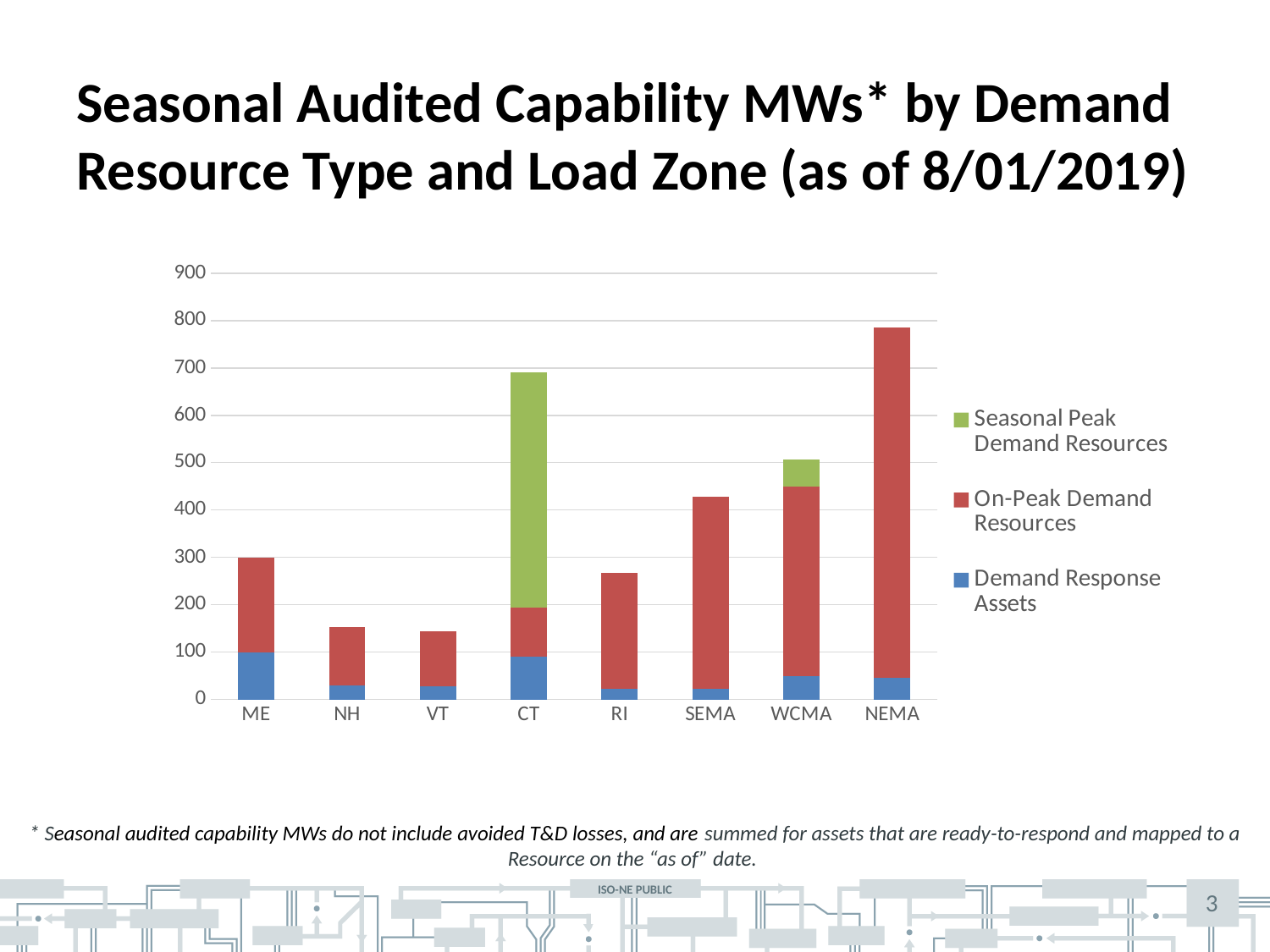
Which has a larger total, SEMA or WCMA? WCMA Which has a larger total, CT or NEMA? NEMA How many load zones are shown on the x axis of the chart? 8 Is the total value for ME greater or less than 400? less Is the total value for CT greater or less than 600? greater What kind of chart is shown on the slide? Stacked bar chart Which colour represents On-Peak Demand Resources in the chart? Red Which load zone has the highest total seasonal audited capability? NEMA Is the total value for NEMA greater or less than 700? greater Which load zone has the largest Seasonal Peak Demand Resources segment? CT How many series does the chart's legend list? 3